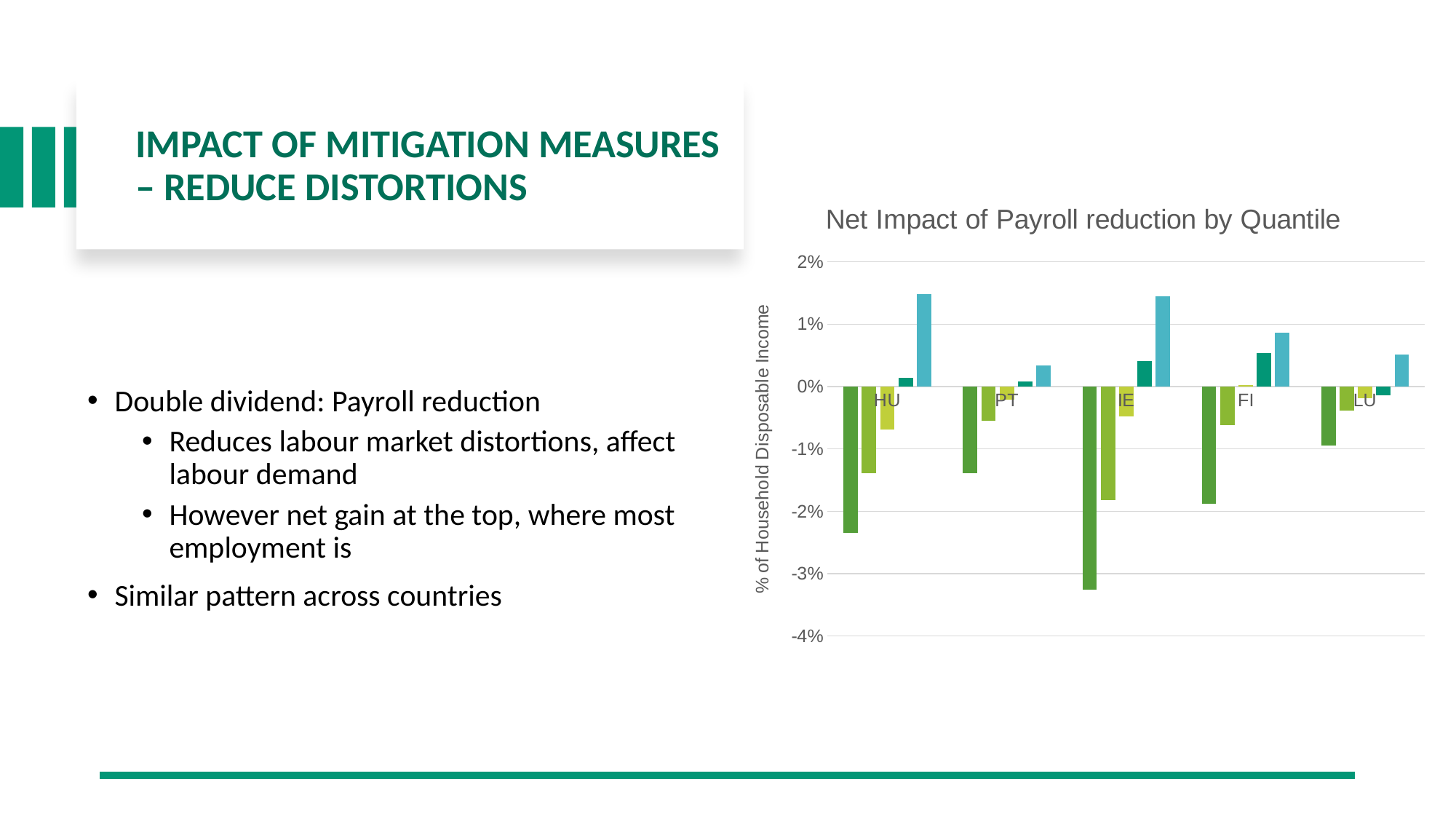
Is the value of the first (dark green) bar for IE greater or less than -3%? less What is the label on the vertical axis of the chart? % of Household Disposable Income What is the title of the chart? Net Impact of Payroll reduction by Quantile Is the value of the light blue bar for HU greater or less than 1%? greater Which is lower, the first (dark green) bar for PT or the first (dark green) bar for HU? HU Which country has the lowest bar in the chart? IE Is the value of the light blue bar for FI greater or less than 1%? less How many countries are shown on the x axis of the chart? 5 What kind of chart is shown on the slide? Bar chart How many bars are plotted for each country in the chart? 5